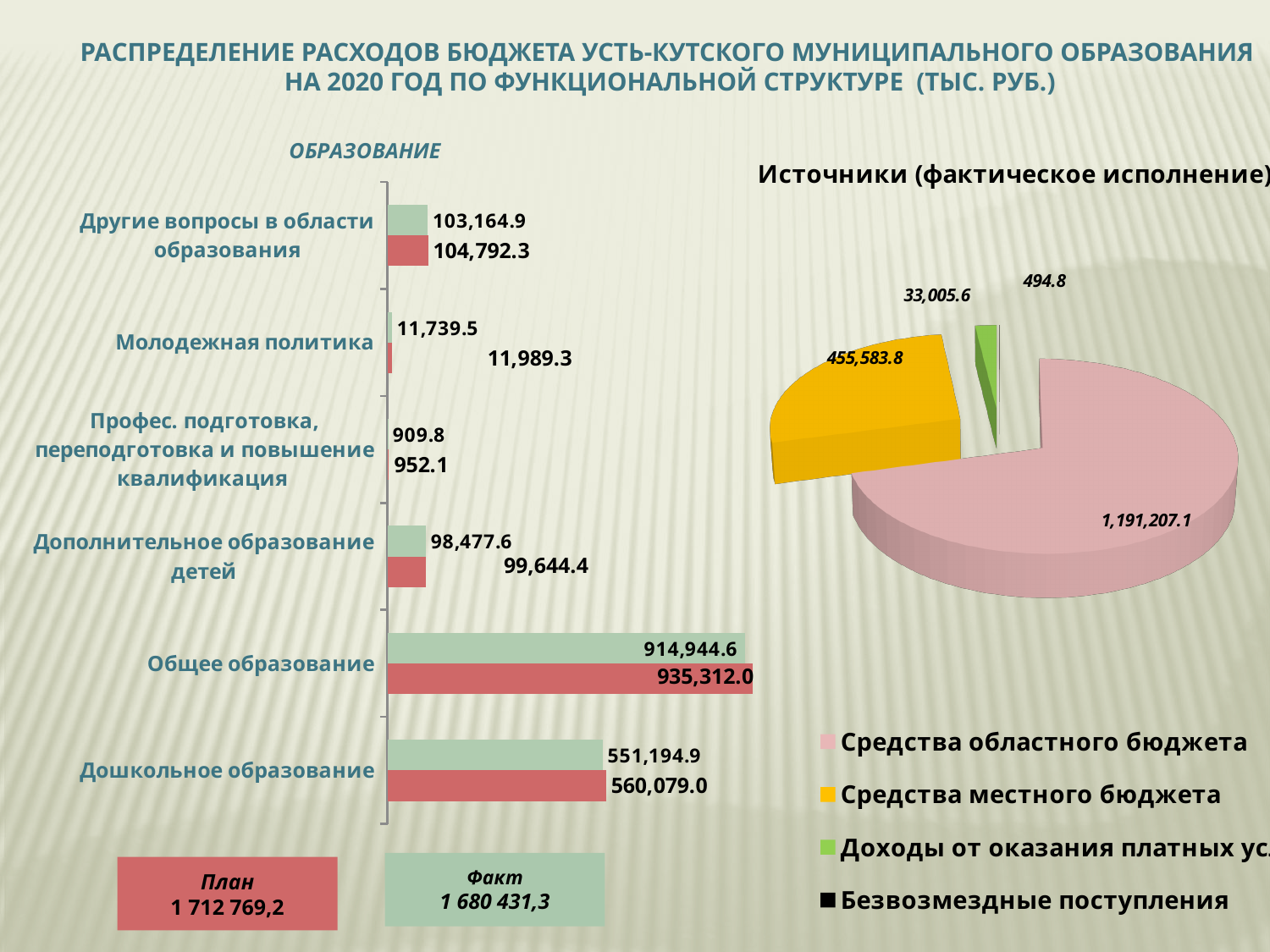
How many series does the bar chart titled ОБРАЗОВАНИЕ show? 2 In the bar chart titled ОБРАЗОВАНИЕ, what is the План value for Дошкольное образование? 560,079.0 How many categories are shown in the bar chart titled ОБРАЗОВАНИЕ? 6 In the bar chart titled ОБРАЗОВАНИЕ, which category has the highest План value? Общее образование In the pie chart titled Источники (фактическое исполнение), what is the value for Средства местного бюджета? 455,583.8 In the bar chart titled ОБРАЗОВАНИЕ, what is the difference between the План and Факт values for Общее образование? 20,367.4 In the bar chart titled ОБРАЗОВАНИЕ, which is larger for Дополнительное образование детей: the План value or the Факт value? План In the bar chart titled ОБРАЗОВАНИЕ, what is the Факт value for Общее образование? 914,944.6 In the pie chart titled Источники (фактическое исполнение), which source has the largest value? Средства областного бюджета In the bar chart titled ОБРАЗОВАНИЕ, what is the План value for Молодежная политика? 11,989.3 What kind of chart is the one titled Источники (фактическое исполнение)? Pie chart In the bar chart titled ОБРАЗОВАНИЕ, which category has the lowest Факт value? Профес. подготовка, переподготовка и повышение квалификация